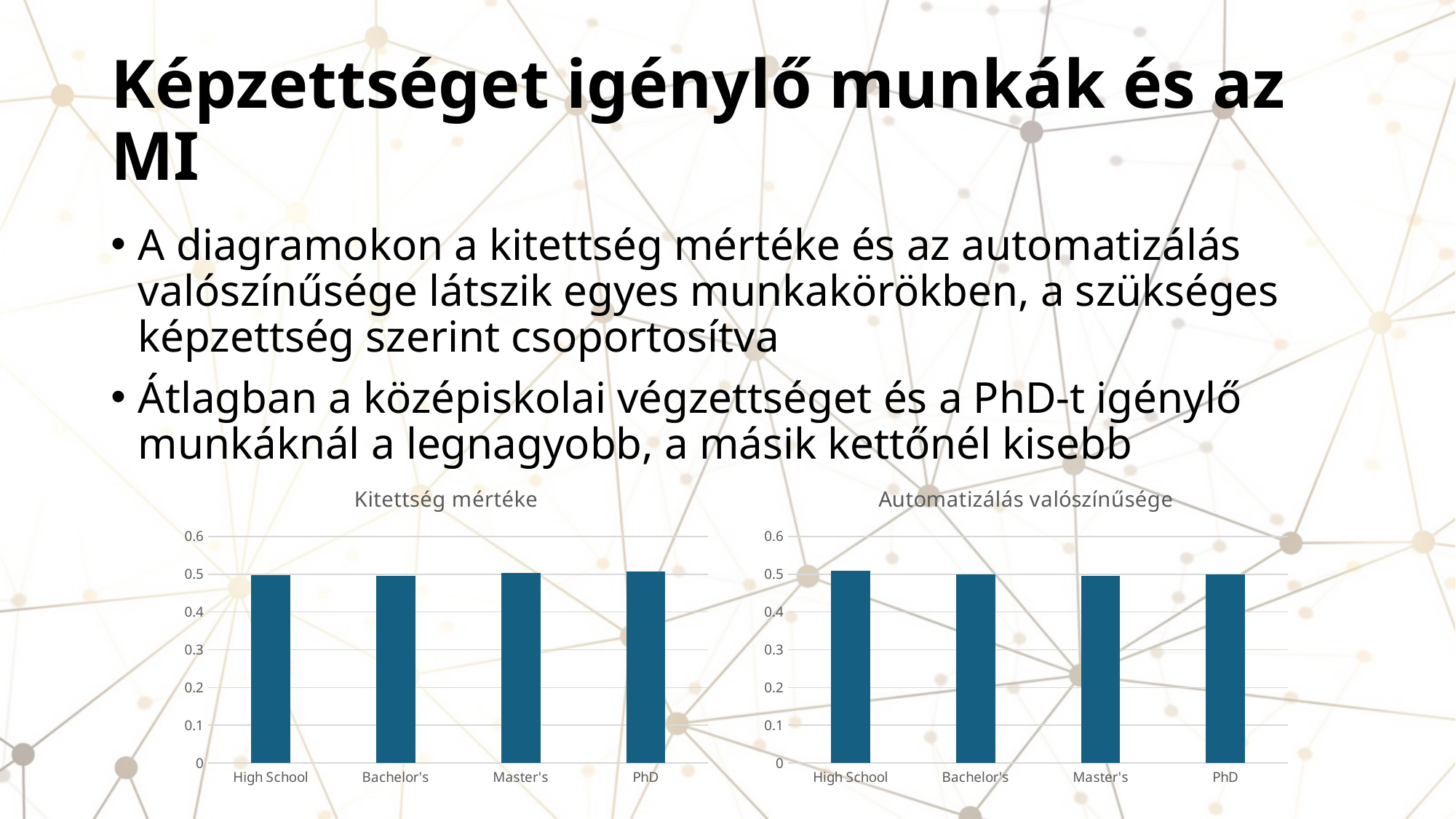
How many categories are shown on the 'Kitettség mértéke' chart? 4 In the 'Kitettség mértéke' chart, is the value for PhD greater or less than 0.4? greater In the 'Automatizálás valószínűsége' chart, is the value for High School greater or less than 0.4? greater What kind of chart is the 'Kitettség mértéke' chart? bar chart What is the title of the chart on the right side of the slide? Automatizálás valószínűsége How many categories are shown on the 'Automatizálás valószínűsége' chart? 4 In the 'Automatizálás valószínűsége' chart, is the value for Master's greater or less than 0.6? less What kind of chart is the 'Automatizálás valószínűsége' chart? bar chart What is the title of the chart on the left side of the slide? Kitettség mértéke In the 'Kitettség mértéke' chart, what is the highest value shown on the vertical axis? 0.6 In the 'Automatizálás valószínűsége' chart, which category is listed first on the horizontal axis? High School